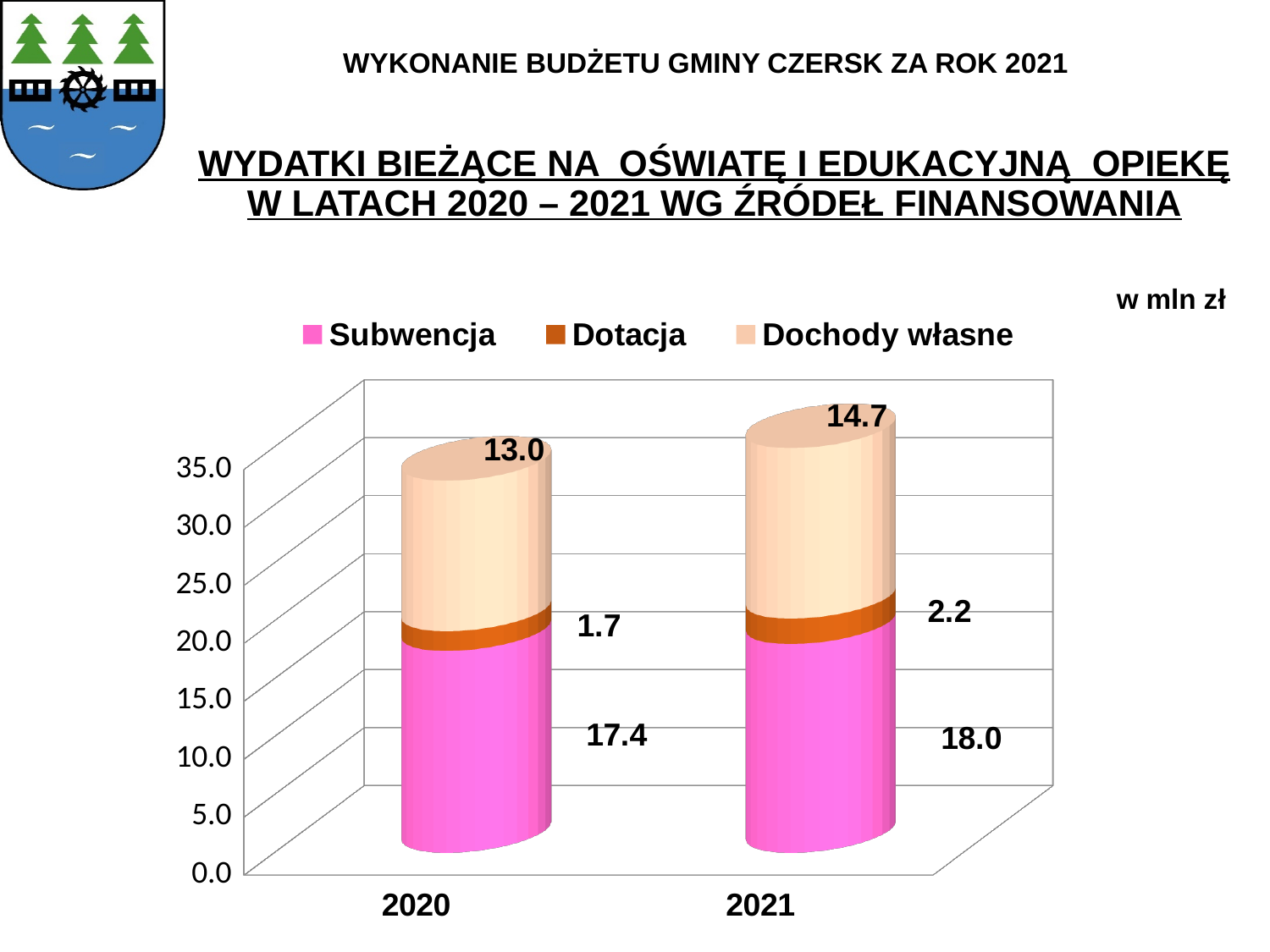
What is the total of the stacked bar for 2020? 32.1 What is the value of Subwencja for 2020? 17.4 What is the value of Dochody własne for 2021? 14.7 What is the value of Dotacja for 2021? 2.2 Which year has the higher value for Dochody własne? 2021 What unit is stated for the values in the chart? w mln zł What is the total of the stacked bar for 2021? 34.9 What is the value of Dotacja for 2020? 1.7 How many years are shown on the x axis? 2 What is the difference between the Subwencja values for 2021 and 2020? 0.6 How many series does the legend list? 3 What is the difference between the Dochody własne values for 2021 and 2020? 1.7